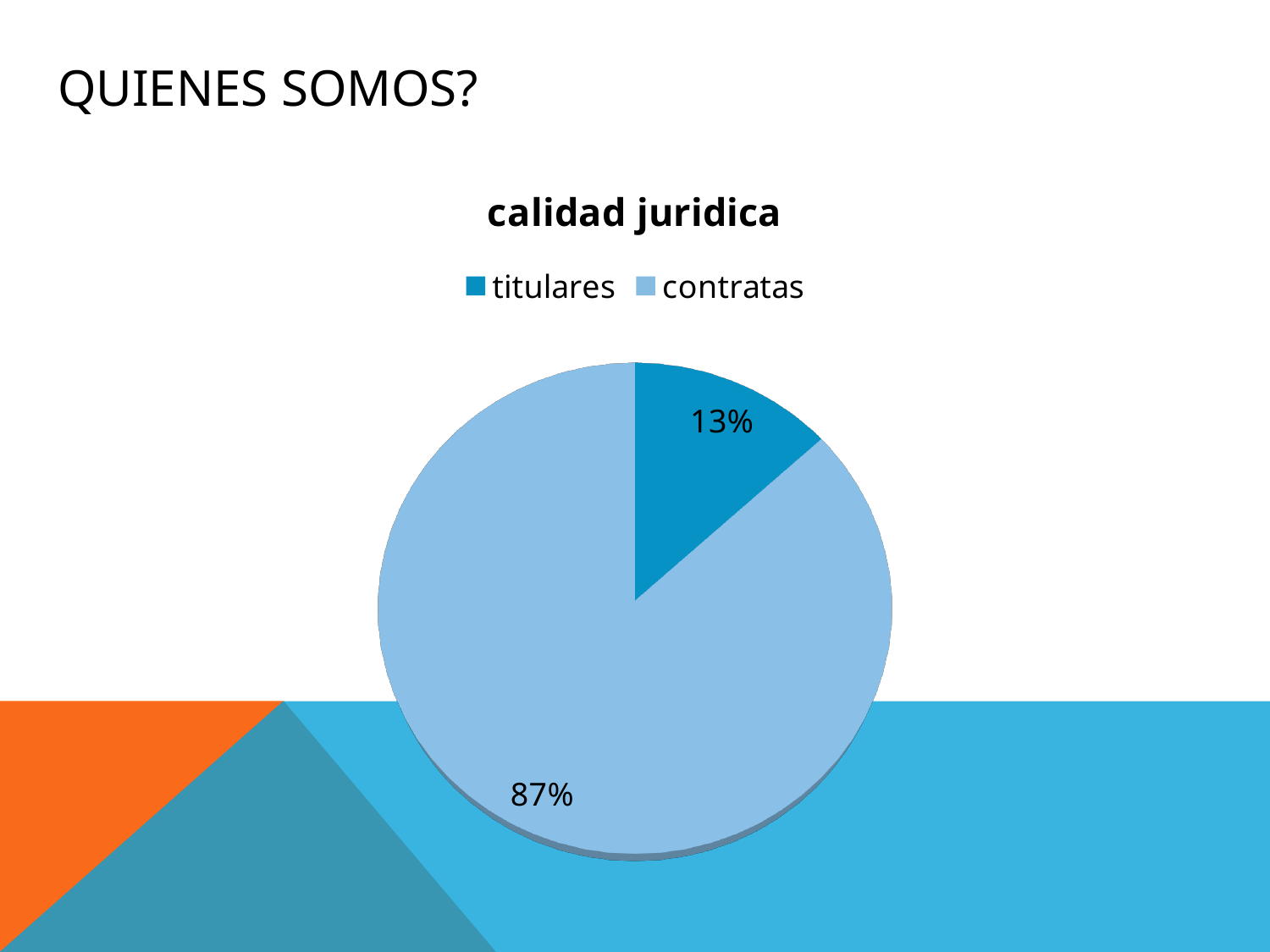
How many entries does the legend list? 2 What share of the pie does the contratas slice represent? 87% What is the difference in percentage points between the contratas and titulares slices? 74 Which category has the smallest slice of the pie? titulares What kind of chart is shown on the slide? pie chart Which category has the largest slice of the pie? contratas What is the title of the chart? calidad juridica What share of the pie does the titulares slice represent? 13% How many categories does the pie chart show? 2 Which legend entry is shown in the darker blue colour? titulares Which is larger, the titulares slice or the contratas slice? contratas